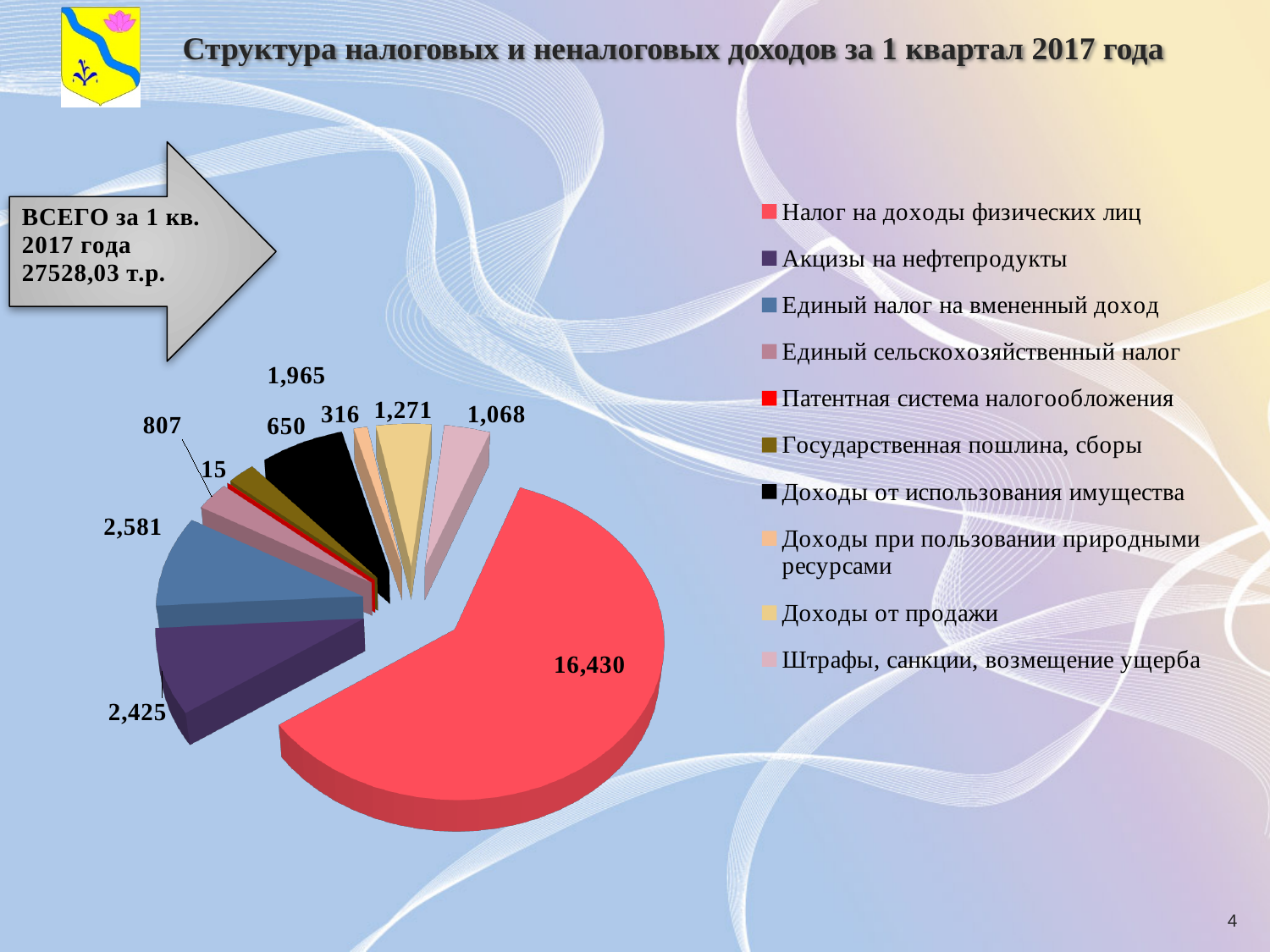
Which is larger: Доходы от продажи or Штрафы, санкции, возмещение ущерба? Доходы от продажи Which category has the largest slice of the pie? Налог на доходы физических лиц What kind of chart is shown on the slide? Pie chart Which category has the smallest slice of the pie? Патентная система налогообложения What is the value for Налог на доходы физических лиц? 16,430 How many categories does the legend list? 10 What is the difference between Единый налог на вмененный доход and Акцизы на нефтепродукты? 156 What is the value for Доходы от использования имущества? 1,965 What is the value for Акцизы на нефтепродукты? 2,425 What is the value for Патентная система налогообложения? 15 What is the value for Единый налог на вмененный доход? 2,581 What is the title of the slide? Структура налоговых и неналоговых доходов за 1 квартал 2017 года